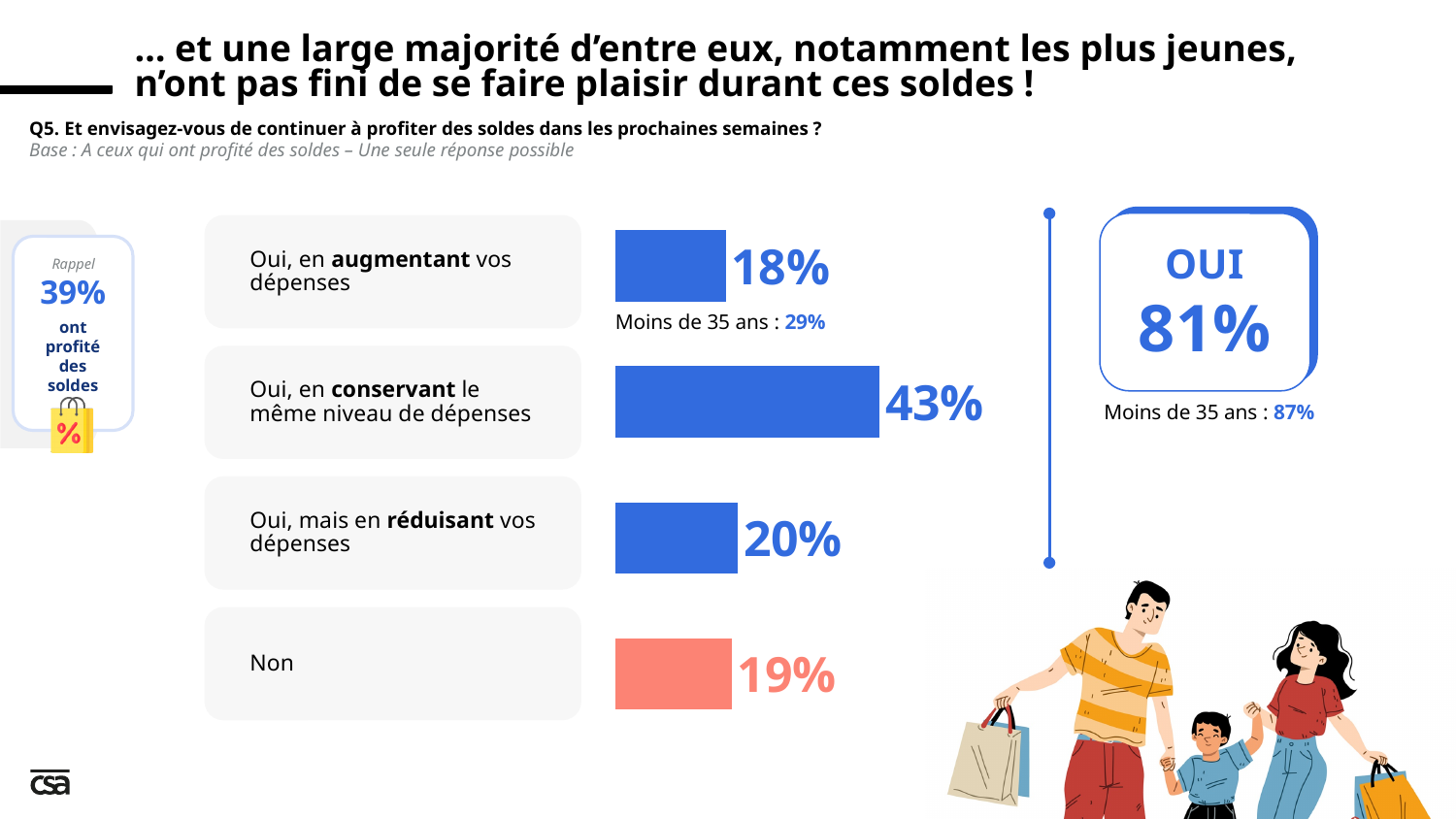
What percentage of respondents answered "Oui, mais en réduisant vos dépenses"? 20% What percentage of respondents answered "Oui, en augmentant vos dépenses"? 18% Which is larger: the percentage for "Oui, mais en réduisant vos dépenses" or for "Non"? Oui, mais en réduisant vos dépenses What percentage of respondents answered "Oui, en conservant le même niveau de dépenses"? 43% How many response categories are shown in the bar chart? 4 Among respondents under 35 ("Moins de 35 ans"), what percentage answered "Oui, en augmentant vos dépenses"? 29% What percentage of respondents answered "Non"? 19% What is the difference in percentage points between "Oui, en conservant le même niveau de dépenses" and "Non"? 24 What is the total percentage of respondents who answered "Oui" (all three Oui categories combined), as shown in the box on the right? 81% What kind of chart is used to show the responses to Q5? Bar chart Which response category has the lowest percentage? Oui, en augmentant vos dépenses Which response category has the highest percentage? Oui, en conservant le même niveau de dépenses